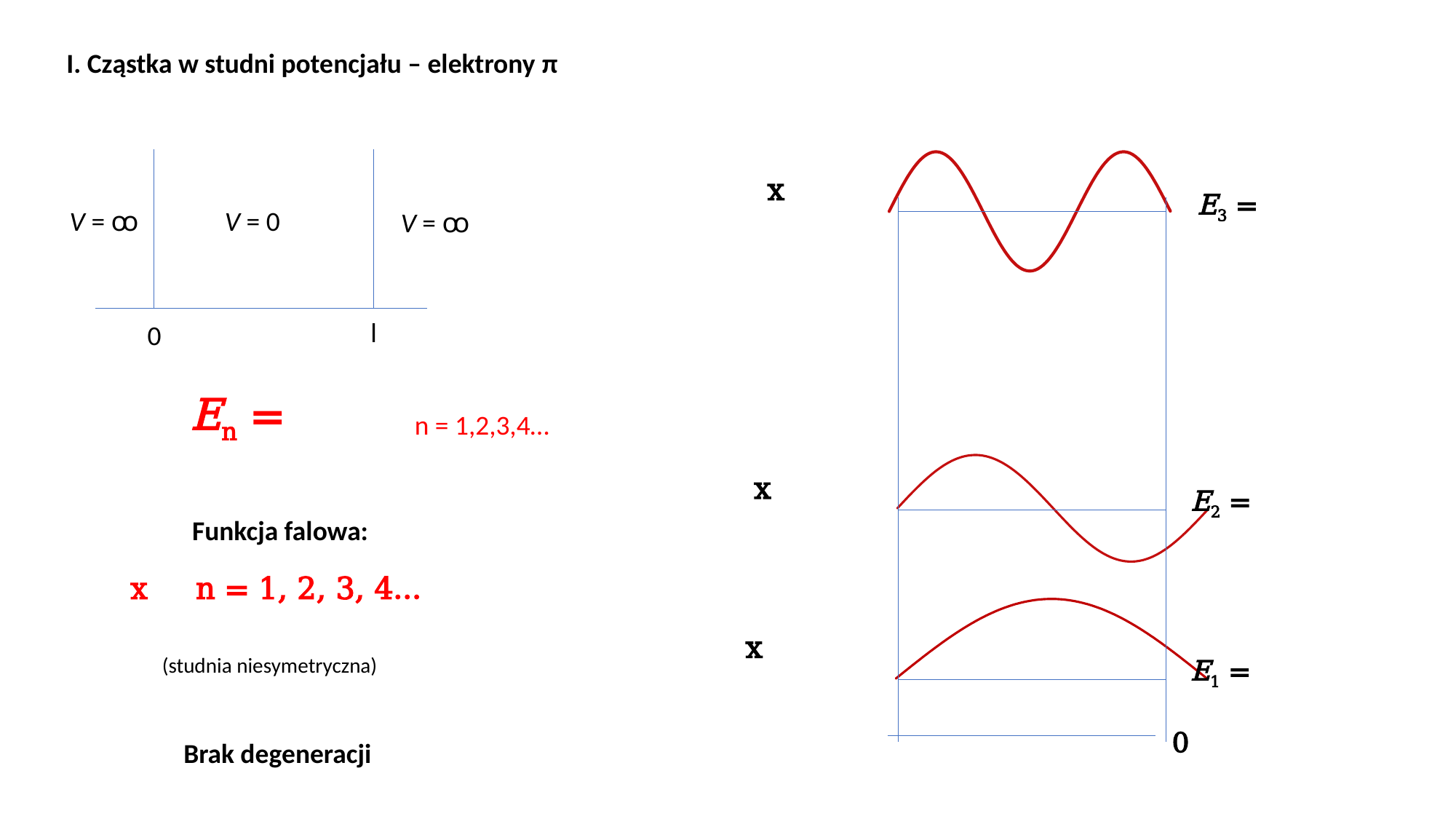
In the diagram on the right, which energy level is drawn lowest? E1 In the potential well diagram on the left, what is the value of V outside the well? V = ∞ In the diagram on the right, which energy level is drawn highest? E3 In the diagram on the right, how many times does the E3 wave function cross its baseline inside the well? 2 What colour are the wave function curves in the diagram on the right? Red In the potential well diagram on the left, what is the value of V inside the well? V = 0 In the potential well diagram on the left, what labels mark the two walls of the well on the horizontal axis? 0 and l How many wave functions are drawn in the diagram on the right side of the slide? 3